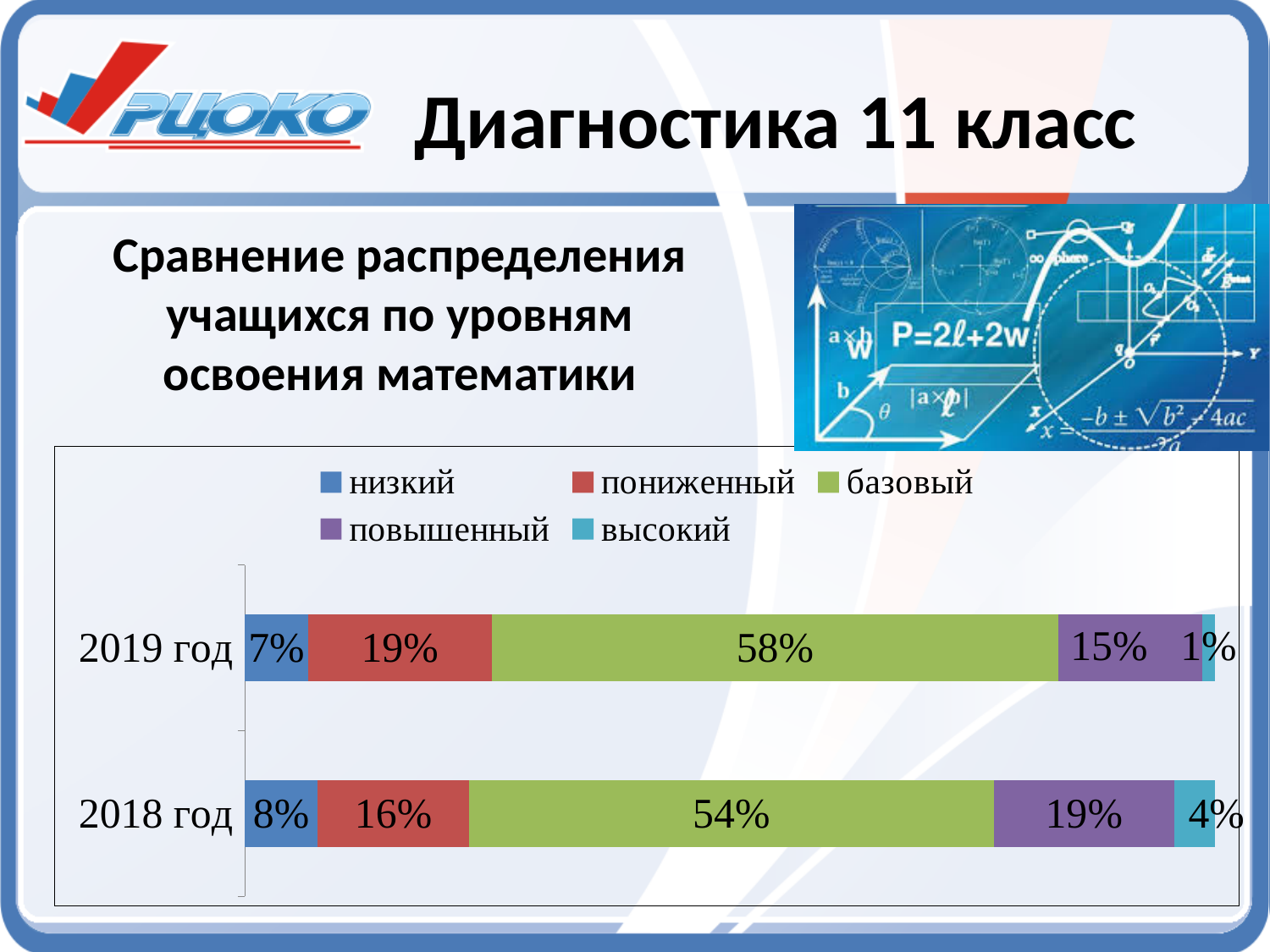
Which series has the largest share in 2018 год? базовый What is the difference between the базовый values for 2019 год and 2018 год? 4% How many categories (years) are plotted on the chart? 2 Which series has the smallest share in 2019 год? высокий Which legend entry is shown in green? базовый Which year has the larger повышенный value, 2019 год or 2018 год? 2018 год What type of chart is shown on the slide? stacked bar chart What is the value of the пониженный series for 2019 год? 19% What is the value of the низкий series for 2018 год? 8% What is the value of the высокий series for 2018 год? 4% What is the value of the базовый series for 2019 год? 58% How many series does the legend list? 5